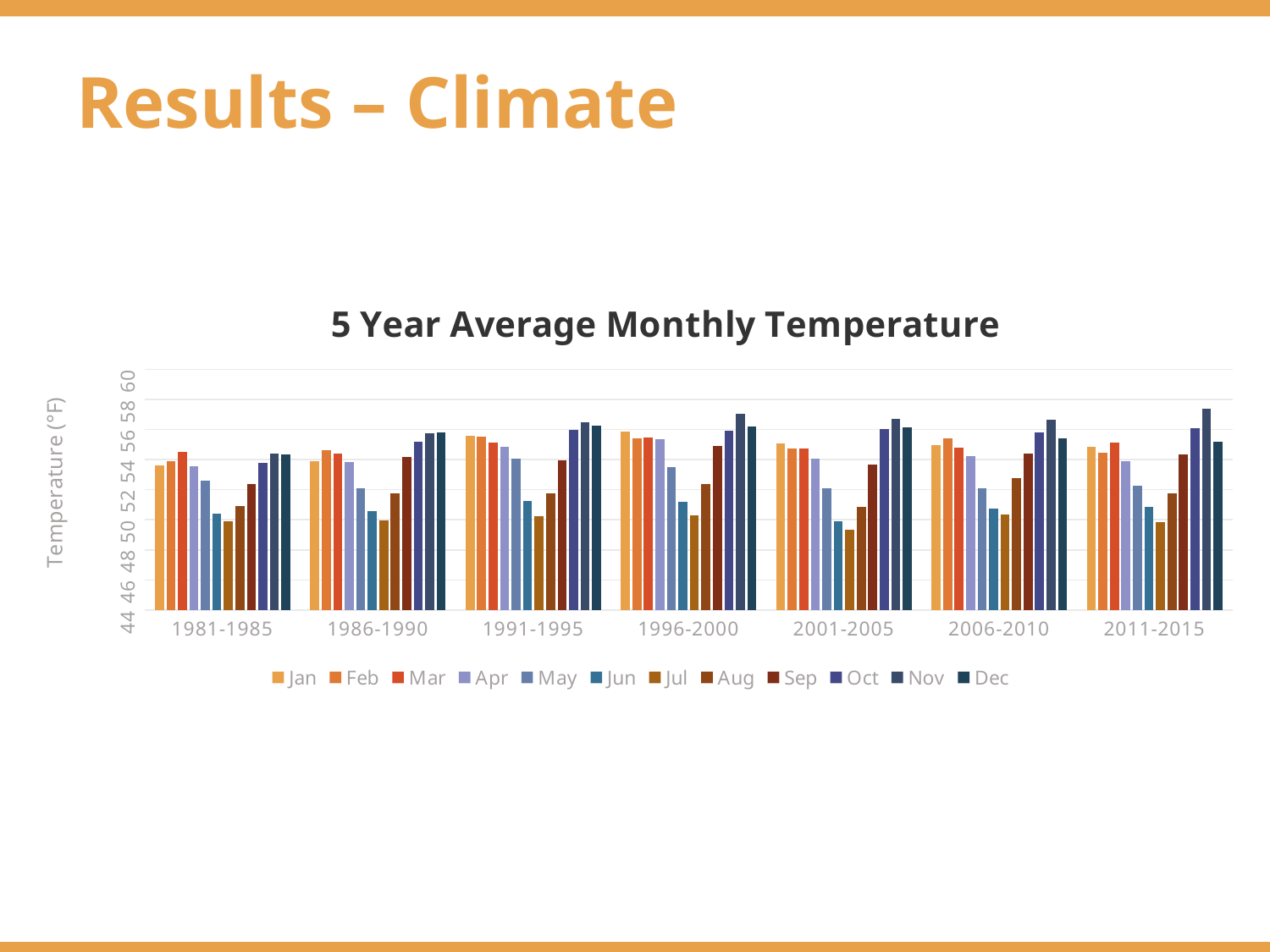
What is the label on the vertical axis of the chart? Temperature (°F) Which month has the highest value in the 1996-2000 period? Nov What is the title of the chart? 5 Year Average Monthly Temperature Is the value for Aug in 2006-2010 greater or less than 52? greater How many five-year periods are shown along the x axis? 7 Is the value for Jul in 1986-1990 greater or less than 52? less Is the value for Mar in 1981-1985 greater or less than 54? greater In the 1981-1985 period, which is larger, the value for Mar or the value for May? Mar How many series does the legend list? 12 What kind of chart is shown on the slide? Bar chart